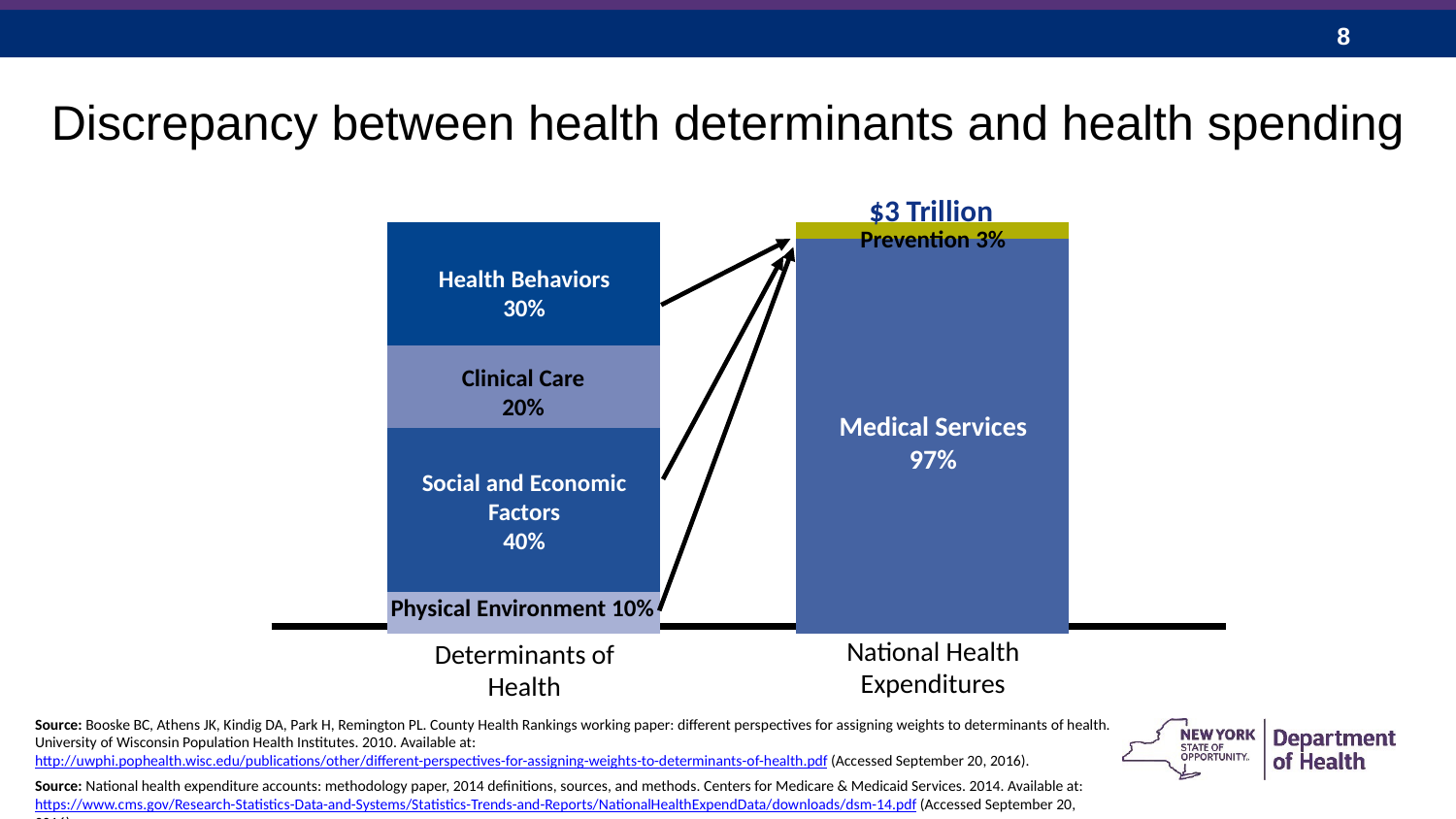
What percentage is shown for Social and Economic Factors in the Determinants of Health bar? 40% Which segment of the Determinants of Health bar is the smallest? Physical Environment What percentage is shown for Health Behaviors in the Determinants of Health bar? 30% What percentage is shown for Physical Environment in the Determinants of Health bar? 10% Which is larger in the Determinants of Health bar: Health Behaviors or Clinical Care? Health Behaviors Which segment of the Determinants of Health bar is the largest? Social and Economic Factors What percentage of National Health Expenditures goes to Medical Services? 97% What total dollar amount is labeled above the National Health Expenditures bar? $3 Trillion How many segments make up the Determinants of Health bar? 4 What percentage of National Health Expenditures goes to Prevention? 3% What percentage is shown for Clinical Care in the Determinants of Health bar? 20% What is the difference between the Medical Services share and the Prevention share of National Health Expenditures? 94%